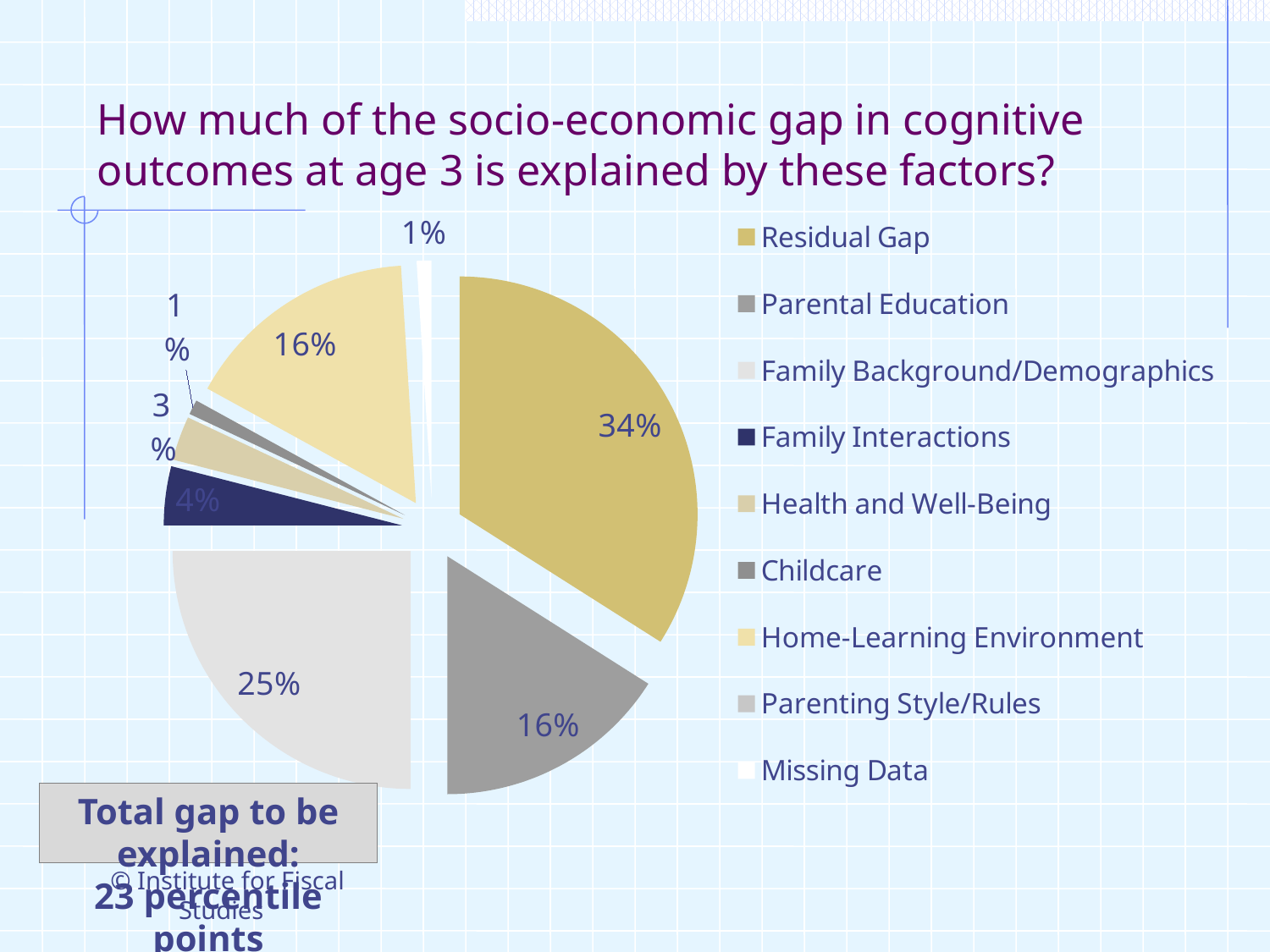
What type of chart is shown on the slide? Pie chart What percentage is shown for Family Interactions? 4% What share of the pie is the Residual Gap? 34% What is the difference in percentage points between the Residual Gap and Family Background/Demographics? 9 percentage points What is the title of the chart? How much of the socio-economic gap in cognitive outcomes at age 3 is explained by these factors? Which category has the largest slice of the pie? Residual Gap What percentage is shown for Parental Education? 16% What percentage is shown for Home-Learning Environment? 16% What percentage is shown for Health and Well-Being? 3% What percentage is shown for Family Background/Demographics? 25% How many entries does the legend list? 9 Which is larger, Family Background/Demographics or Parental Education? Family Background/Demographics